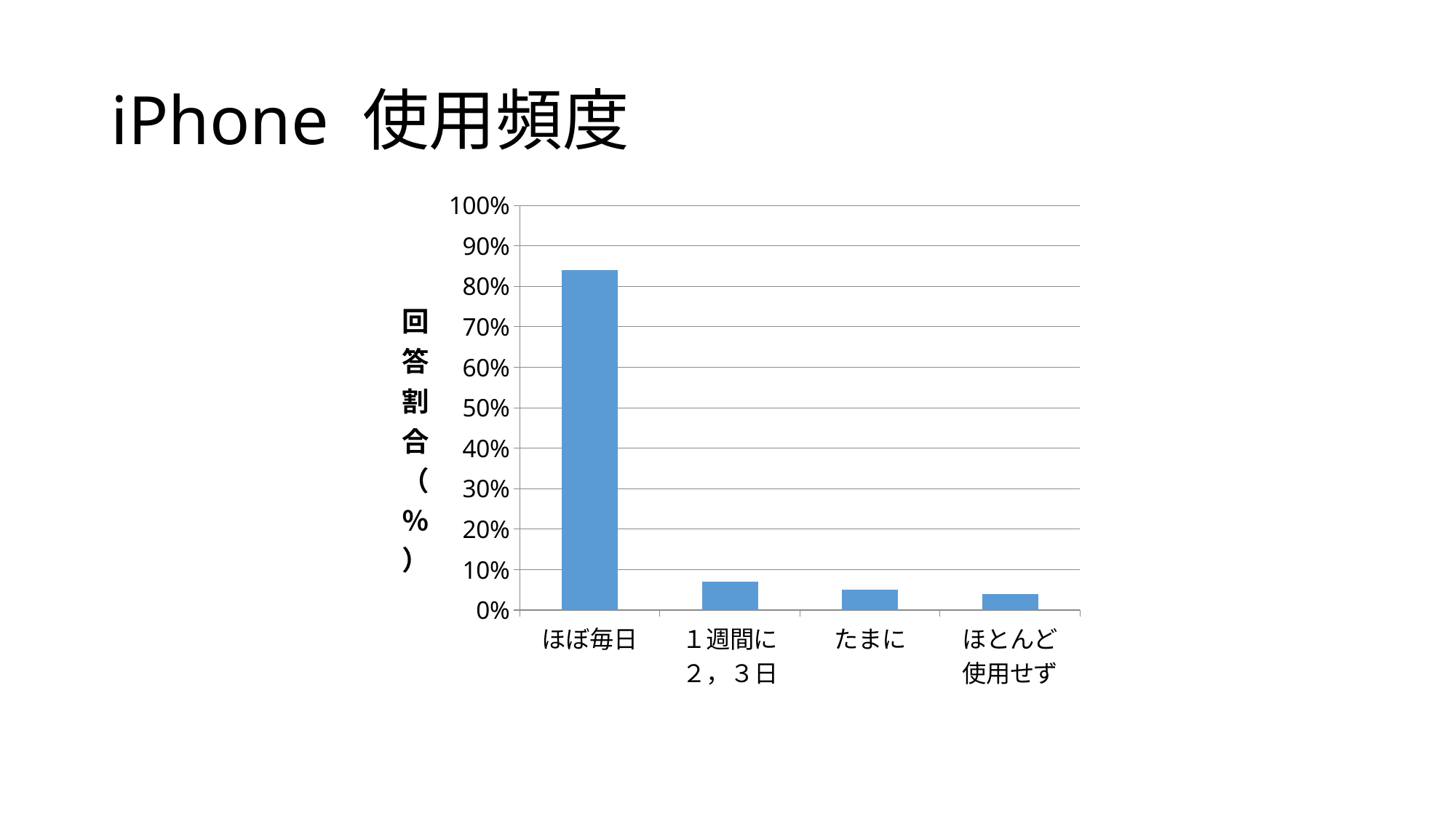
Is the value for たまに greater or less than 10%? less What kind of chart is shown on the slide? bar chart Is the value for ほぼ毎日 greater or less than 80%? greater Which is larger, the value for ほぼ毎日 or the value for たまに? ほぼ毎日 What is the title of the slide containing the chart? iPhone 使用頻度 What is the label on the vertical axis of the chart? 回答割合（%） Is the value for ほぼ毎日 greater or less than 90%? less How many categories are shown on the x axis of the chart? 4 Which category has the highest value in the chart? ほぼ毎日 Do the values rise or fall moving from left to right along the x axis? fall